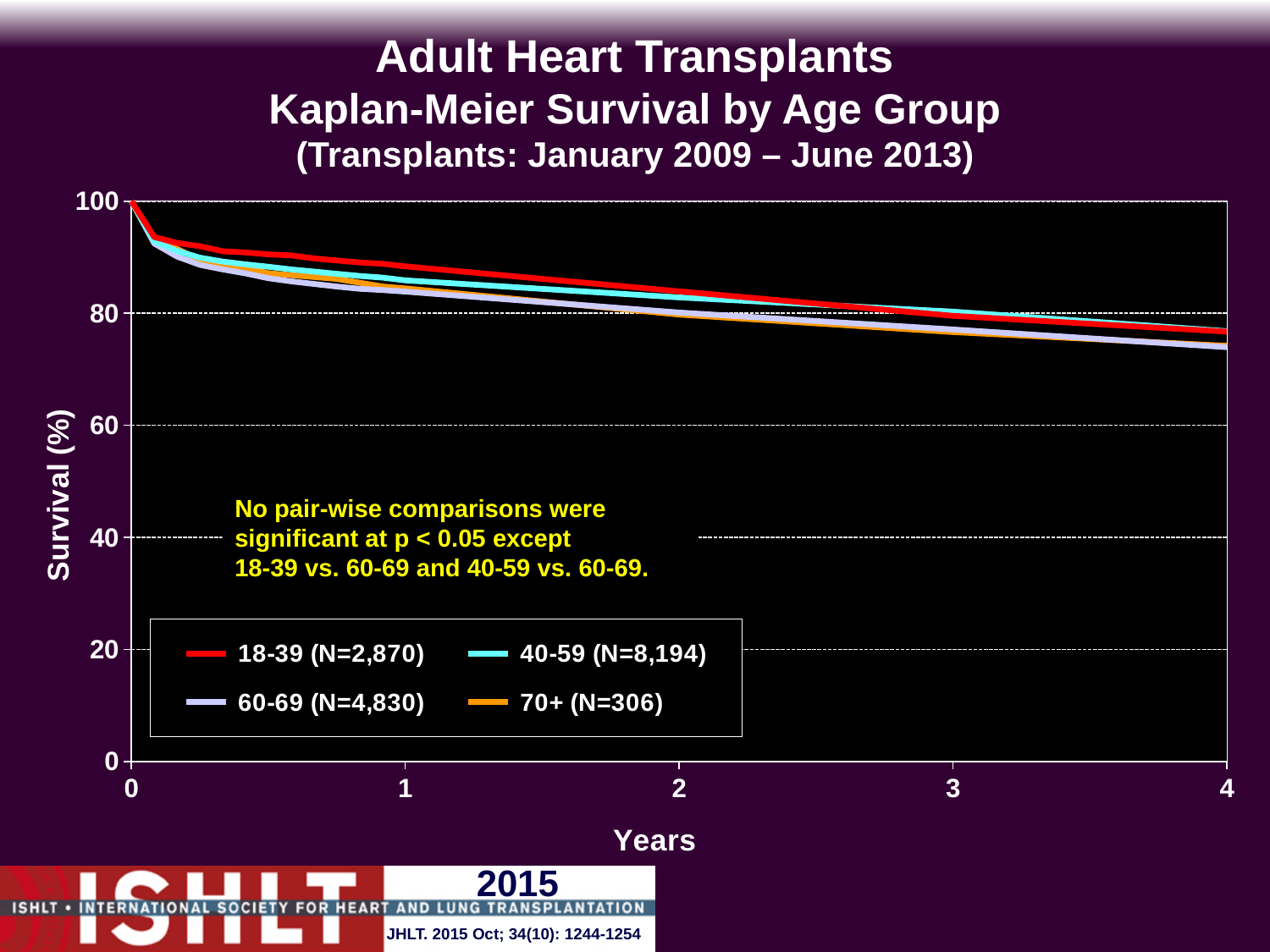
Is the survival for the 18-39 group at 4 years greater or less than 80? less What is the survival value for all age groups at year 0? 100 What is the N shown in the legend for the 70+ age group? 306 At 4 years, which group has higher survival: 18-39 or 60-69? 18-39 Is the survival for the 60-69 group at 1 year greater or less than 80? greater How many age groups (series) does the legend list? 4 Do the survival curves rise or fall as years increase? fall Is the survival for the 70+ group at 4 years greater or less than 80? less What kind of chart is shown on the slide? line chart What is the label of the y axis? Survival (%)